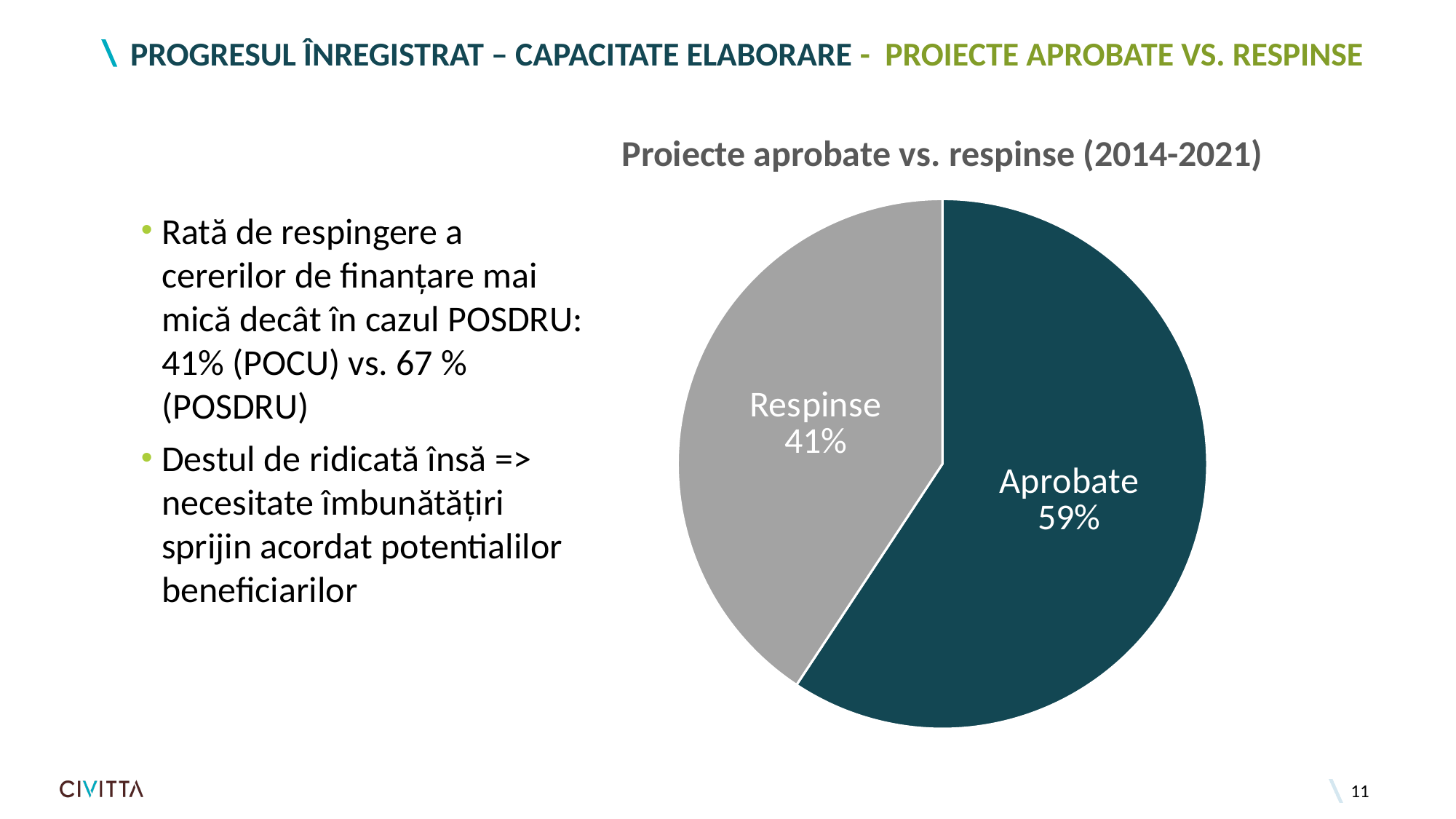
Which slice of the pie is the smallest? Respinse What share of the pie does the Respinse slice represent? 41% What is the title of the chart? Proiecte aprobate vs. respinse (2014-2021) How many slices does the pie chart have? 2 What percentage of projects were Aprobate? 59% Which slice of the pie is the largest? Aprobate What colour is the Aprobate slice? dark teal Which is larger, the share of Aprobate or the share of Respinse? Aprobate What percentage of projects were Respinse? 41% What type of chart is shown on the slide? pie chart What is the difference in percentage points between Aprobate and Respinse? 18